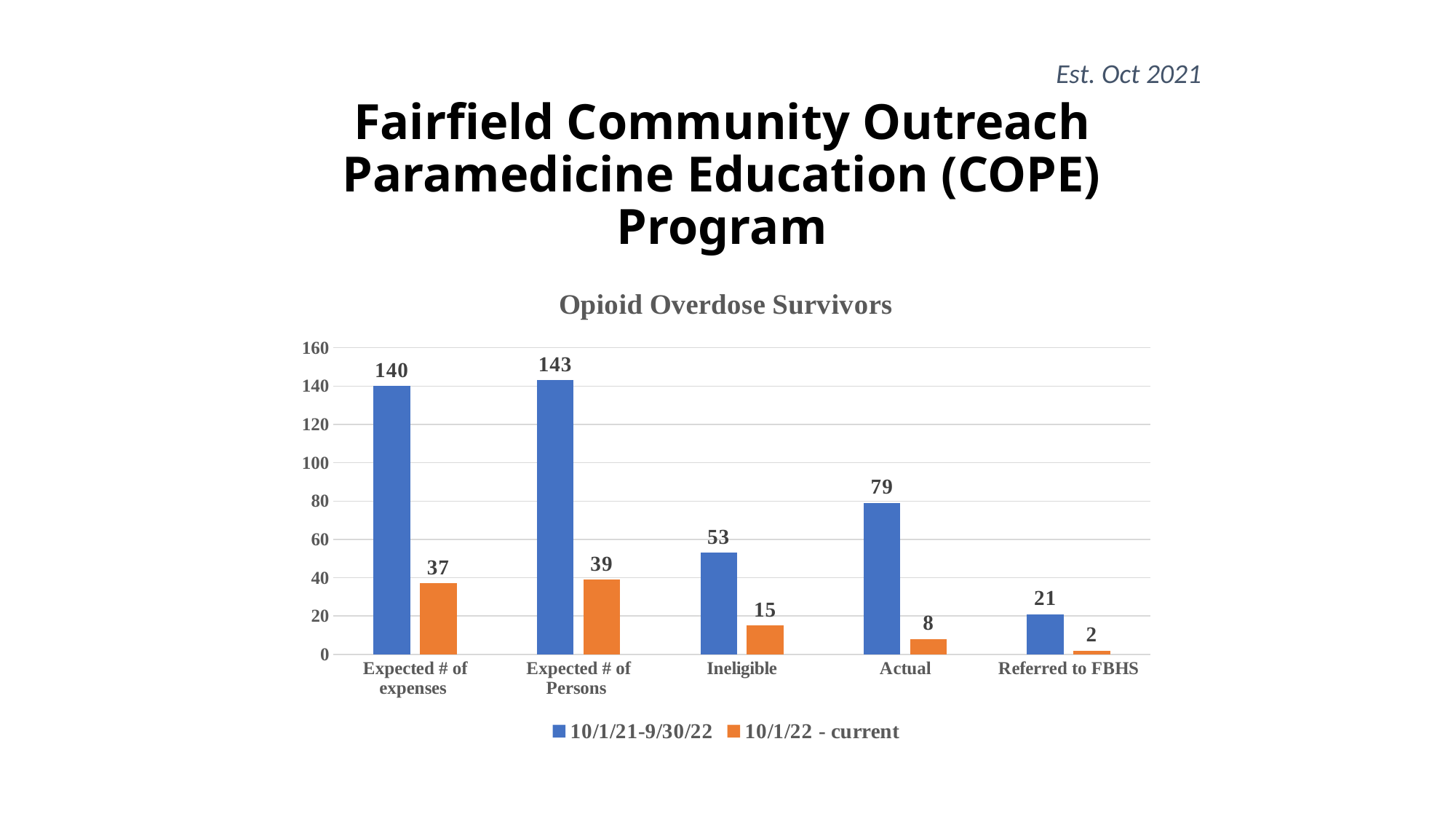
How many categories are shown on the x axis? 5 What is the value for Ineligible in the 10/1/22 - current series? 15 How many series does the legend list? 2 What is the difference between the 10/1/21-9/30/22 and 10/1/22 - current values for Actual? 71 What is the value for Referred to FBHS in the 10/1/21-9/30/22 series? 21 What is the difference between the Expected # of Persons and Expected # of expenses values in the 10/1/21-9/30/22 series? 3 Which category has the lowest value in the 10/1/22 - current series? Referred to FBHS Which is larger: the 10/1/22 - current value for Expected # of expenses or for Expected # of Persons? Expected # of Persons What is the title of the chart? Opioid Overdose Survivors What is the value for Actual in the 10/1/21-9/30/22 series? 79 Is the value for Ineligible in the 10/1/21-9/30/22 series greater or less than 60? less Which category has the highest value in the 10/1/21-9/30/22 series? Expected # of Persons